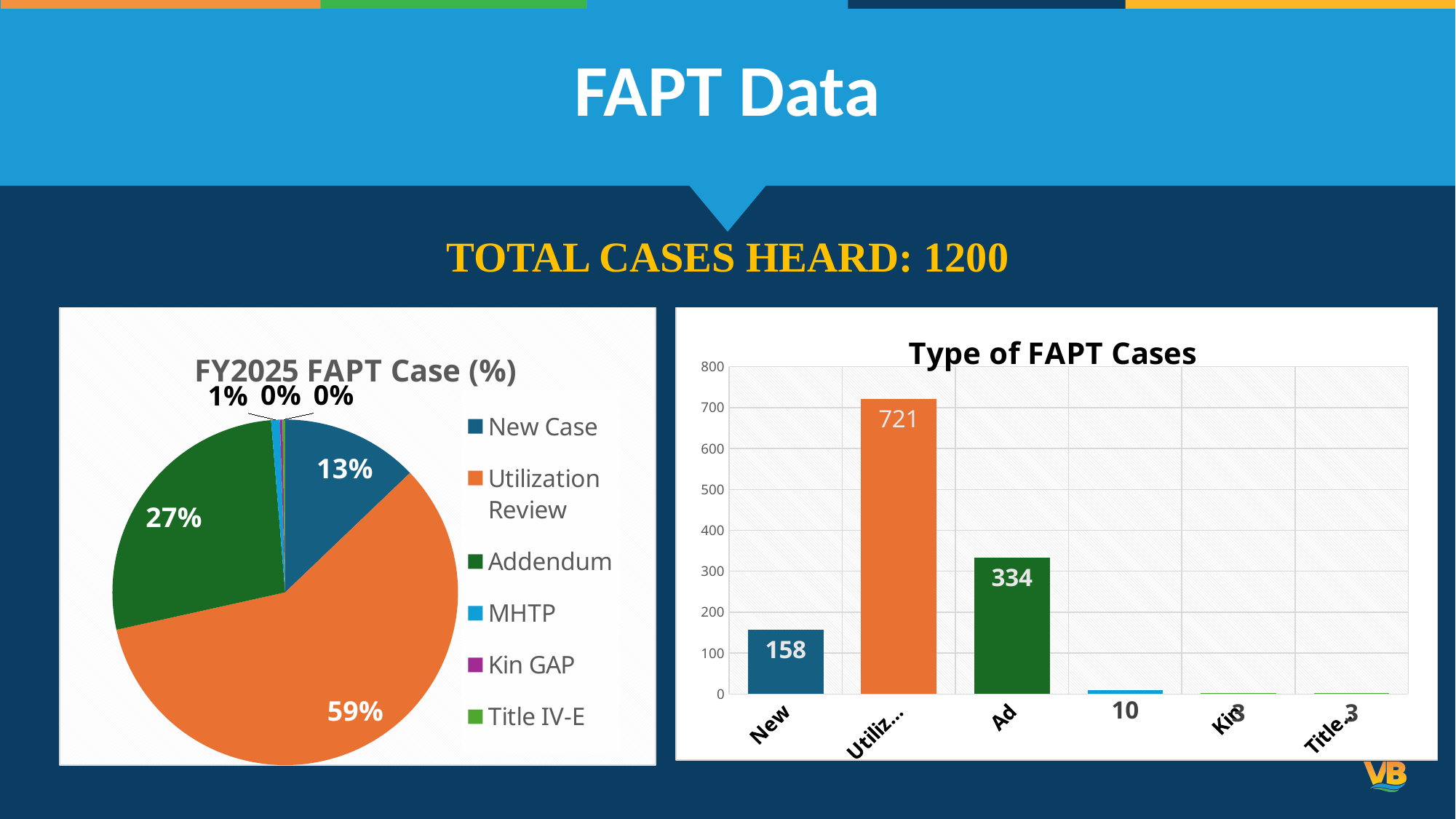
What kind of chart is the chart titled 'Type of FAPT Cases'? bar chart In the pie chart titled 'FY2025 FAPT Case (%)', how many entries does the legend list? 6 In the bar chart titled 'Type of FAPT Cases', what is the difference between the second bar (721) and the third bar (334)? 387 In the bar chart titled 'Type of FAPT Cases', what is the value of the tallest bar? 721 In the pie chart titled 'FY2025 FAPT Case (%)', what percentage is shown for Utilization Review? 59% In the bar chart titled 'Type of FAPT Cases', what is the value of the third bar (Ad)? 334 In the bar chart titled 'Type of FAPT Cases', what is the value of the first bar (New)? 158 In the pie chart titled 'FY2025 FAPT Case (%)', what percentage is shown for Addendum? 27% In the pie chart titled 'FY2025 FAPT Case (%)', which category has the largest slice? Utilization Review In the pie chart titled 'FY2025 FAPT Case (%)', what is the difference in percentage points between Utilization Review and Addendum? 32 In the pie chart titled 'FY2025 FAPT Case (%)', what percentage is shown for New Case? 13% In the bar chart titled 'Type of FAPT Cases', how many bars are plotted? 6